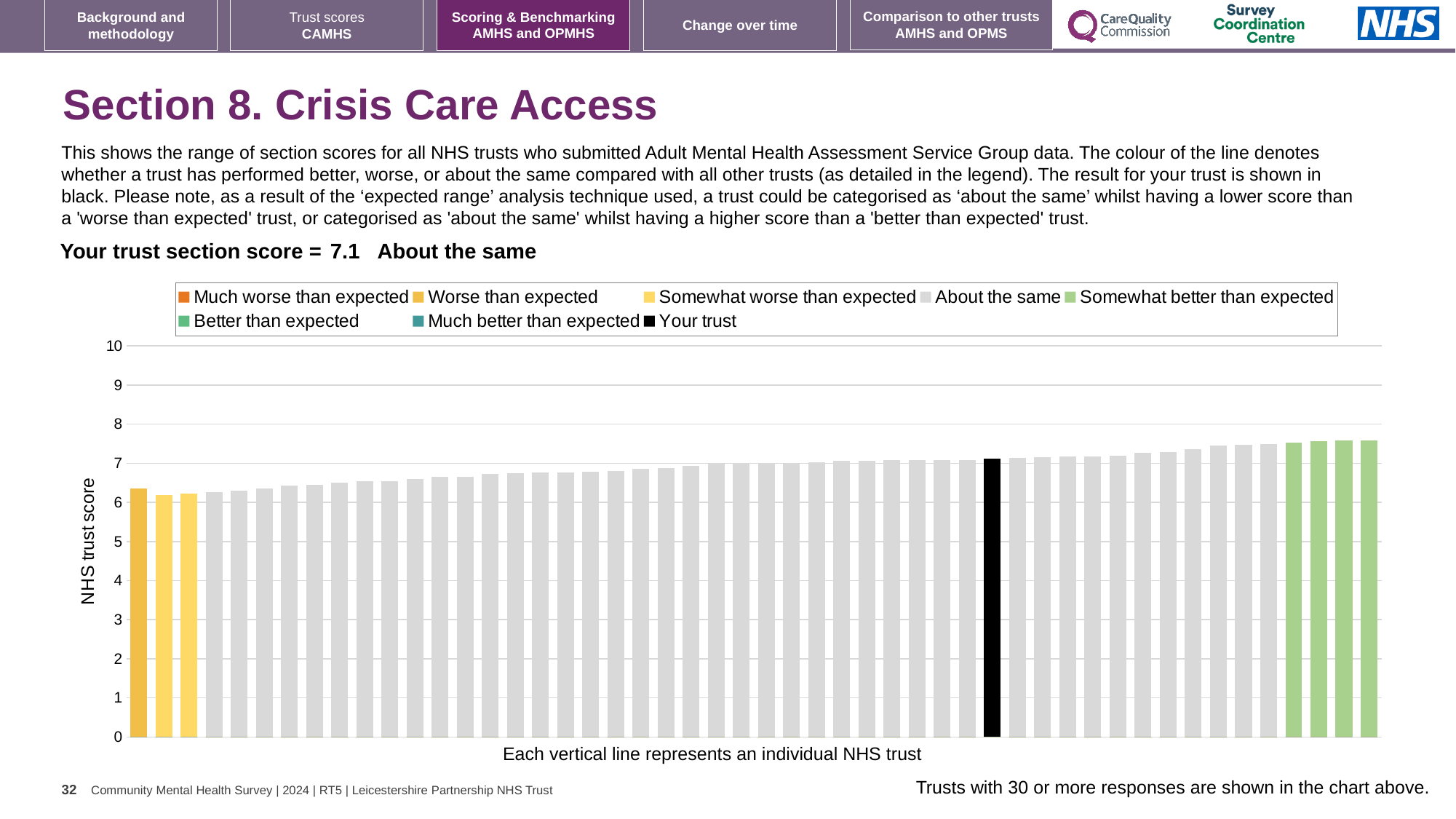
How many entries does the chart legend list? 8 Is the value of the highest bar in the chart greater or less than 8? less What colour is the bar representing your trust? black What is the label on the y axis of the chart? NHS trust score How is your trust's score categorised compared with other trusts? About the same Is the value for your trust (the black bar) greater or less than 5? greater How many bars are coloured green (somewhat better than expected)? 4 Do the bar values rise or fall from left to right along the x axis? rise What kind of chart is shown on the slide? bar chart Is the value of the lowest bar in the chart greater or less than 5? greater What is your trust's section score for Crisis Care Access? 7.1